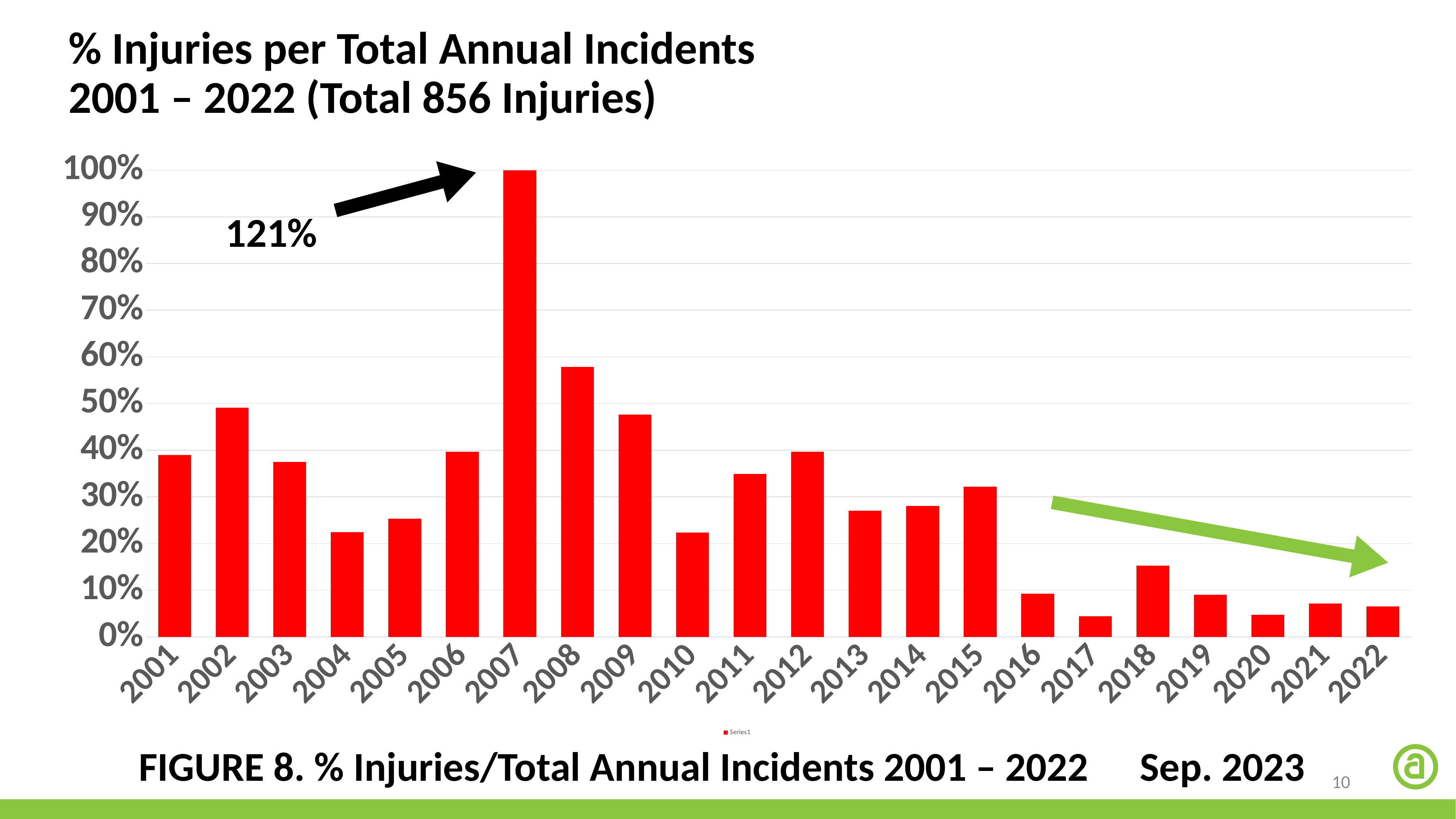
Which year has the highest bar in the chart? 2007 Which year has the larger value, 2011 or 2013? 2011 Is the value for 2004 greater or less than 30%? less Do the values rise or fall from 2008 to 2010? fall Is the value for 2002 greater or less than 40%? greater What is the title of the chart? % Injuries per Total Annual Incidents 2001 – 2022 (Total 856 Injuries) Is the value for 2018 greater or less than 10%? greater What percentage does the annotation with the black arrow pointing to the 2007 bar state? 121% How many years are shown on the x axis of the chart? 22 Which year has the larger value, 2008 or 2009? 2008 What kind of chart is shown on the slide? bar chart